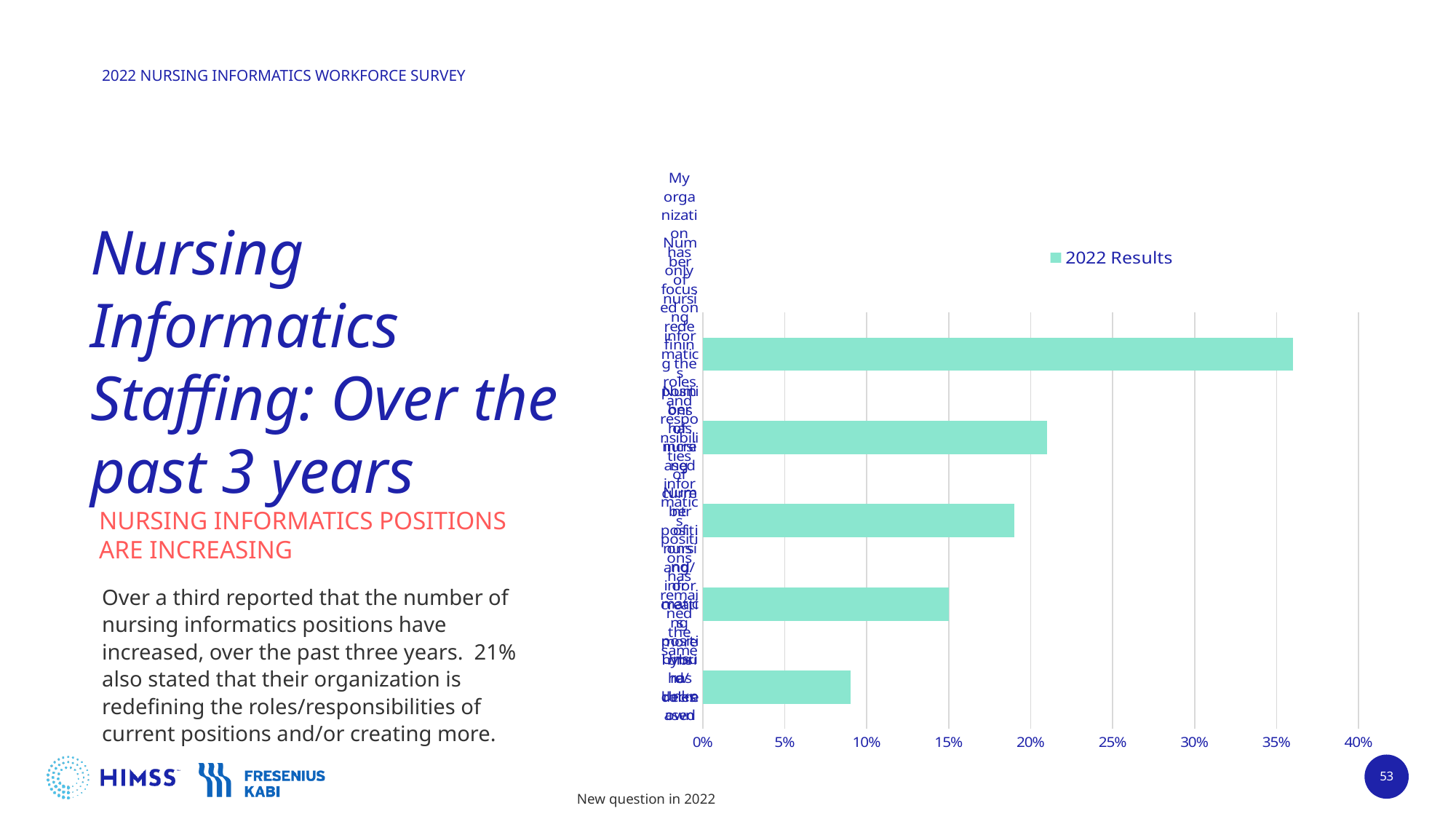
Is the value of the bottom bar greater or less than 5%? greater Is the value of the second bar from the top greater or less than 25%? less What kind of chart is shown on the slide? bar chart Which bar has the highest value, the top bar or the bottom bar? the top bar How many series does the chart legend list? 1 Which bar in the chart has the lowest value? the bottom bar Is the value of the third bar from the top greater or less than 15%? greater What is the maximum value shown on the chart's horizontal axis? 40% What is the name of the series shown in the chart legend? 2022 Results How many bars are plotted in the chart? 5 Do the bar values increase or decrease going from the top bar to the bottom bar? decrease